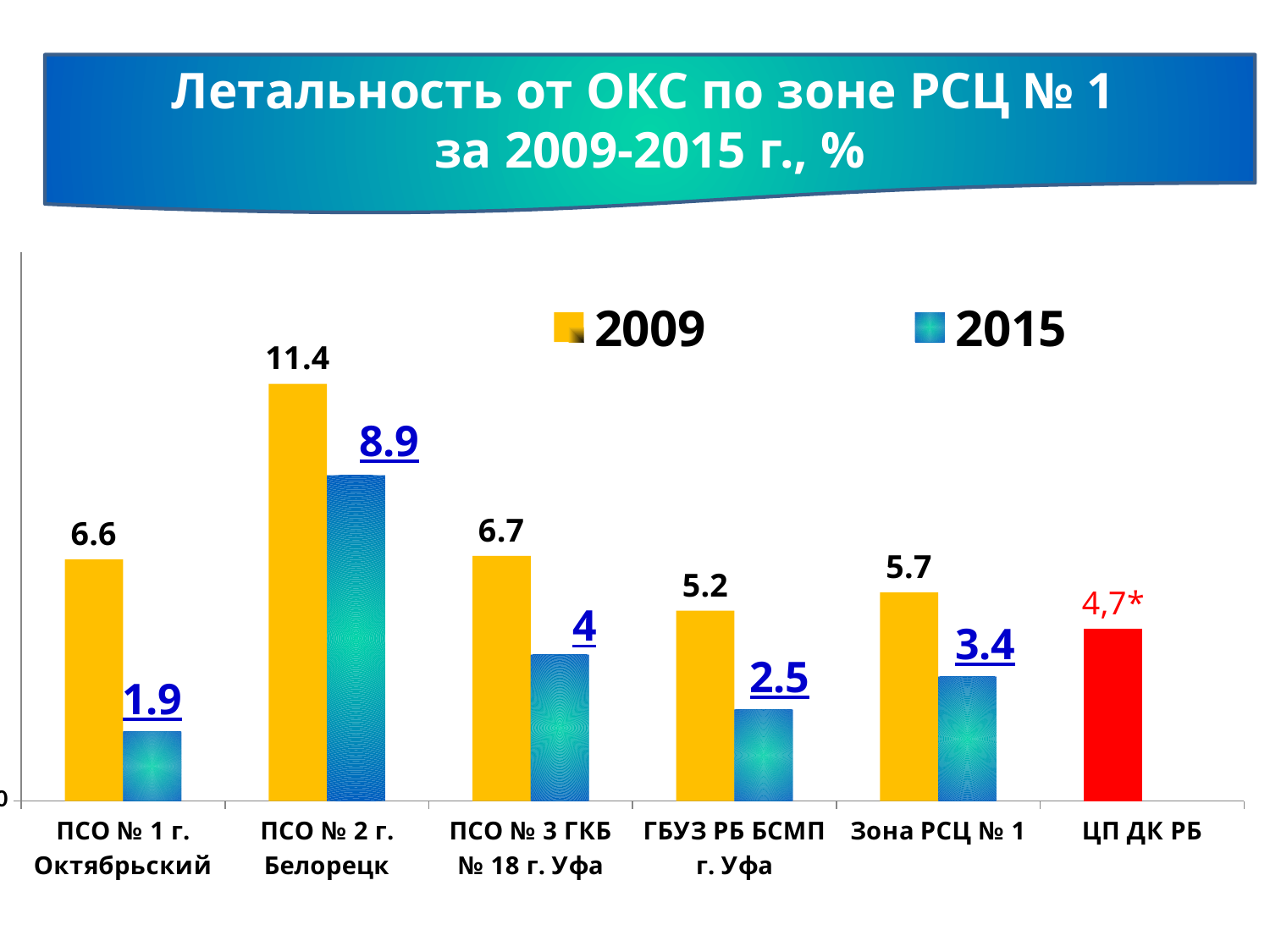
What is the 2015 value for ПСО № 1 г. Октябрьский? 1.9 What is the 2015 value for ГБУЗ РБ БСМП г. Уфа? 2.5 What is the 2009 value for ПСО № 2 г. Белорецк? 11.4 Which category has the highest 2009 value? ПСО № 2 г. Белорецк What is the difference between the 2009 and 2015 values for Зона РСЦ № 1? 2.3 What is the title of the chart? Летальность от ОКС по зоне РСЦ № 1 за 2009-2015 г., % What value is shown for ЦП ДК РБ? 4,7* How many categories are shown on the x axis? 6 Which category has the lowest 2015 value? ПСО № 1 г. Октябрьский How many series does the legend list? 2 Which is larger for ПСО № 3 ГКБ № 18 г. Уфа: the 2009 value or the 2015 value? 2009 What kind of chart is shown on the slide? Bar chart